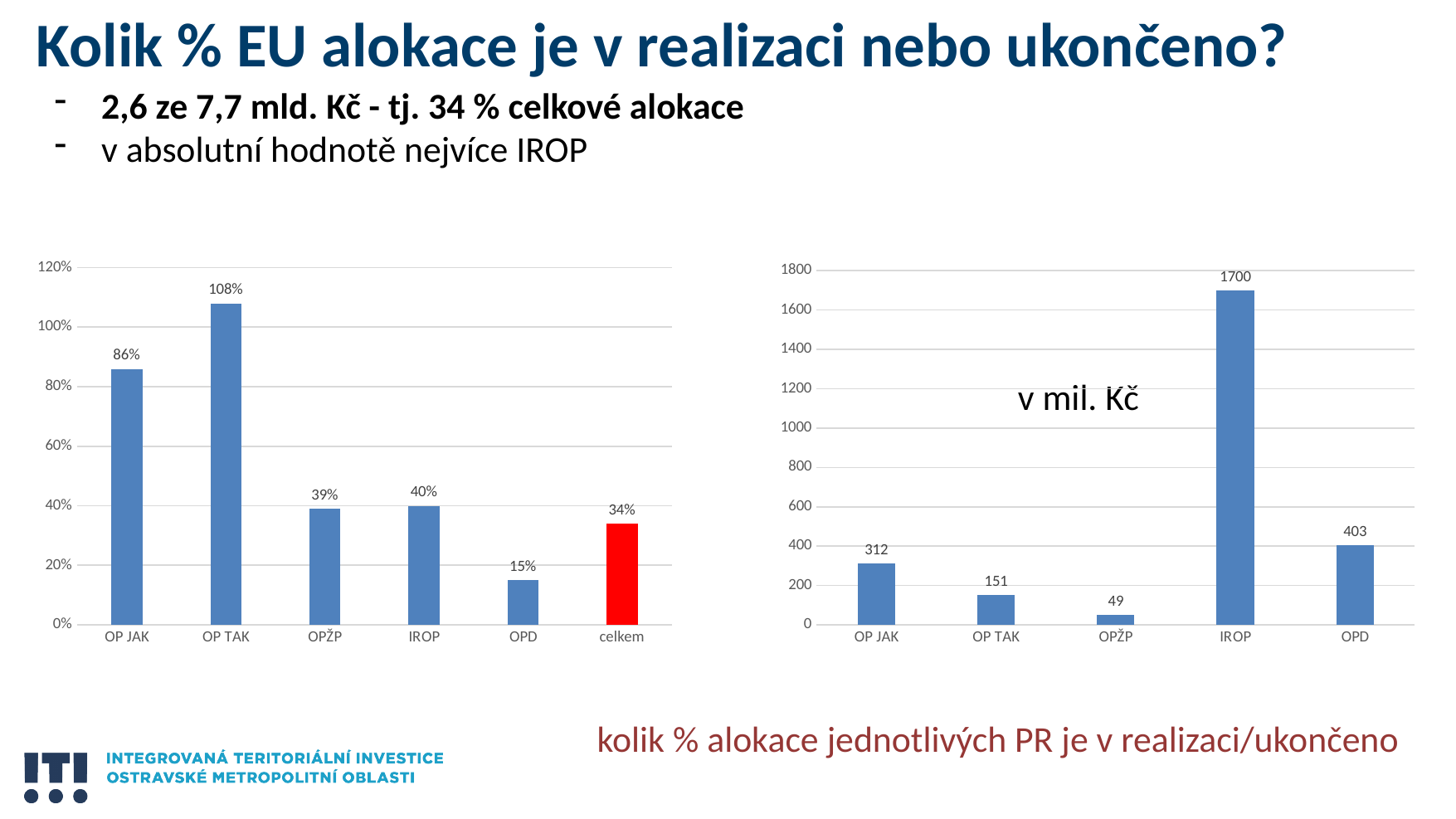
In the left chart (percentages), which category has the highest value? OP TAK In the right chart (v mil. Kč), what is the value for IROP? 1700 In the right chart (v mil. Kč), what is the value for OPŽP? 49 In the left chart (percentages), what is the value for OP TAK? 108% In the left chart (percentages), what is the value for OPD? 15% In the right chart (v mil. Kč), what is the difference between OPD and OP JAK? 91 In the left chart (percentages), what is the difference between OP JAK and IROP? 46% What type of chart is the right chart (v mil. Kč)? bar chart In the left chart (percentages), how many categories are shown on the x axis? 6 In the left chart (percentages), which category has the lowest value? OPD In the right chart (v mil. Kč), which category has the highest value? IROP In the left chart (percentages), which bar is coloured red? celkem